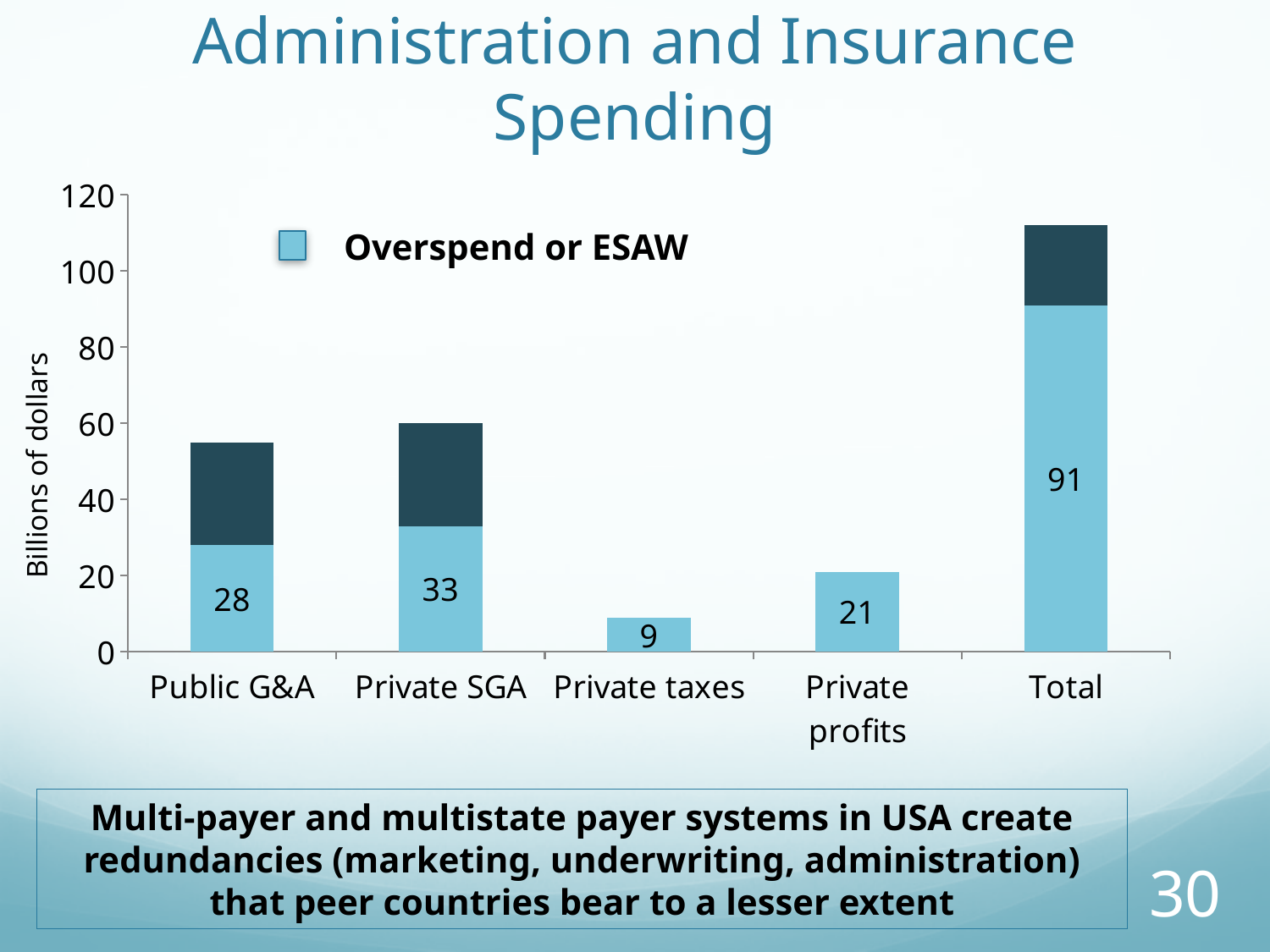
Which has a larger Overspend or ESAW value, Private profits or Private taxes? Private profits What is the Overspend or ESAW value for Public G&A? 28 What is the difference between the Overspend or ESAW values for Private SGA and Public G&A? 5 Is the full height of the Total bar greater or less than 100? greater What is the Overspend or ESAW value for Total? 91 What is the Overspend or ESAW value for Private profits? 21 What is the label on the y axis? Billions of dollars What is the Overspend or ESAW value for Private SGA? 33 What is the Overspend or ESAW value for Private taxes? 9 Which category has the lowest Overspend or ESAW value? Private taxes How many categories are shown on the x axis? 5 Excluding the Total bar, which category has the highest Overspend or ESAW value? Private SGA